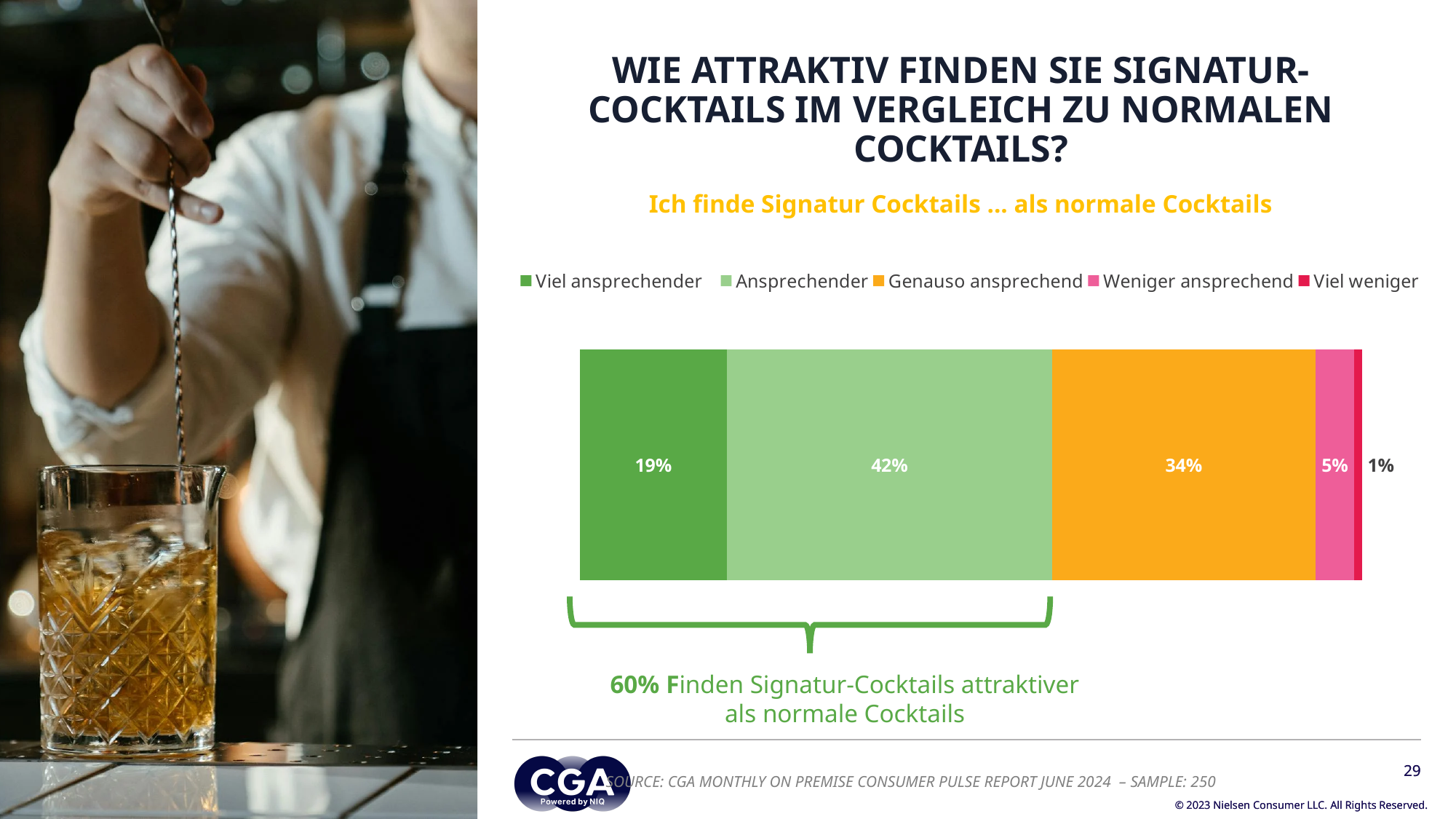
Which response category has the largest share? Ansprechender Which response category has the smallest share? Viel weniger What percentage of respondents find signature cocktails 'Viel ansprechender' than normal cocktails? 19% What is the difference between the 'Ansprechender' and 'Genauso ansprechend' shares? 8% What percentage of respondents chose 'Genauso ansprechend'? 34% What percentage of respondents chose 'Weniger ansprechend'? 5% What percentage of respondents chose 'Ansprechender'? 42% What kind of chart is shown on the slide? Stacked bar chart What is the combined share of 'Viel ansprechender' and 'Ansprechender'? 61% What percentage of respondents chose 'Viel weniger'? 1% Which is larger, the share for 'Viel ansprechender' or for 'Genauso ansprechend'? Genauso ansprechend How many series does the legend list? 5